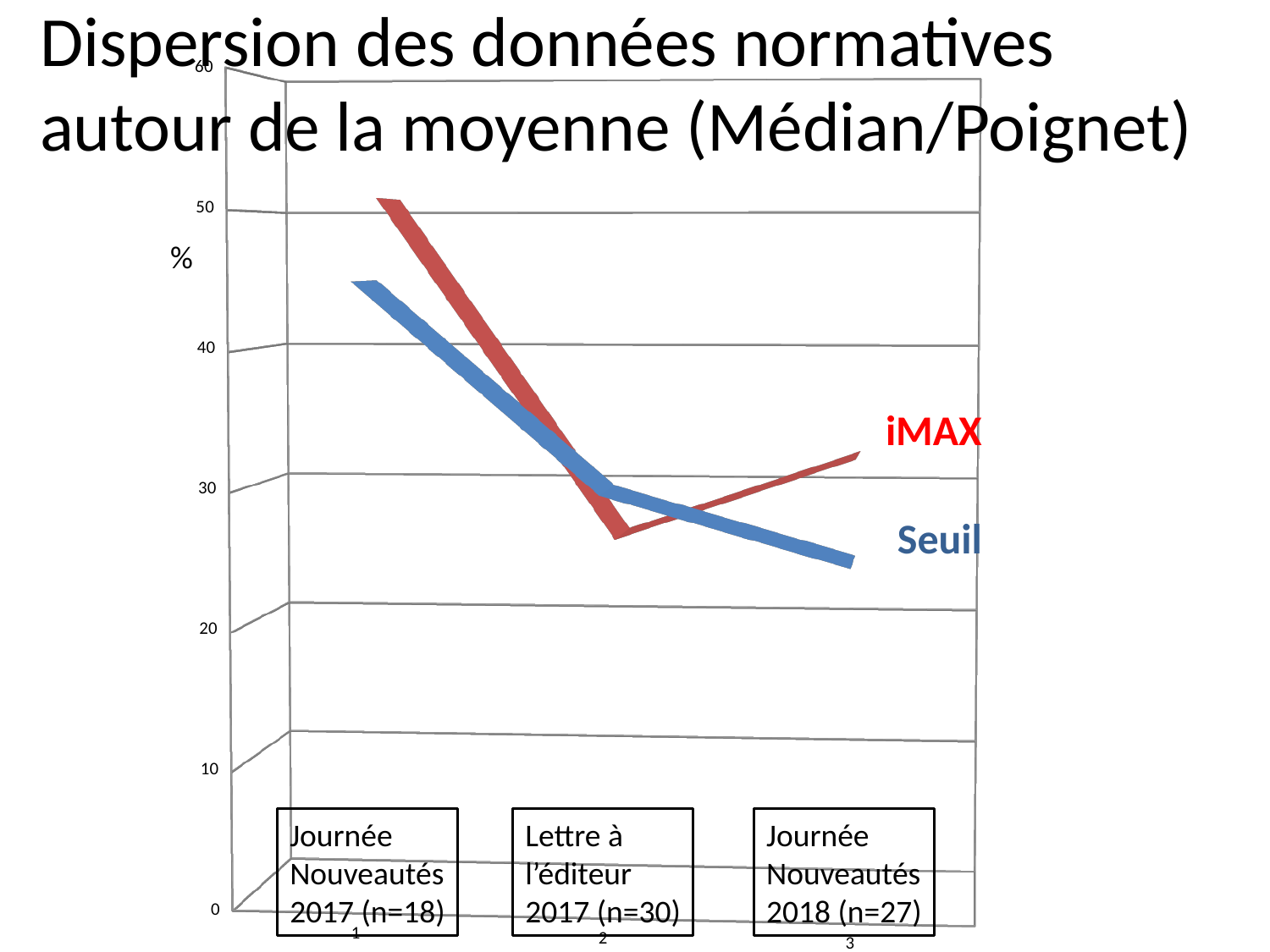
Is the iMAX value for Lettre à l'éditeur 2017 (n=30) greater or less than 30? less Is the Seuil value for Journée Nouveautés 2018 (n=27) greater or less than 30? less At Journée Nouveautés 2018 (n=27), which series has the higher value, iMAX or Seuil? iMAX How many categories are shown along the x axis? 3 At Journée Nouveautés 2017 (n=18), which series has the higher value, iMAX or Seuil? iMAX How many series are plotted on the chart? 2 Does the Seuil series rise or fall from left to right across the x axis? Fall What kind of chart is shown on the slide? Line chart Is the iMAX value for Journée Nouveautés 2017 (n=18) greater or less than 40? greater What are the names of the two series on the chart? iMAX and Seuil For which category is the iMAX series at its lowest? Lettre à l'éditeur 2017 (n=30) What unit is shown on the y axis of the chart? %